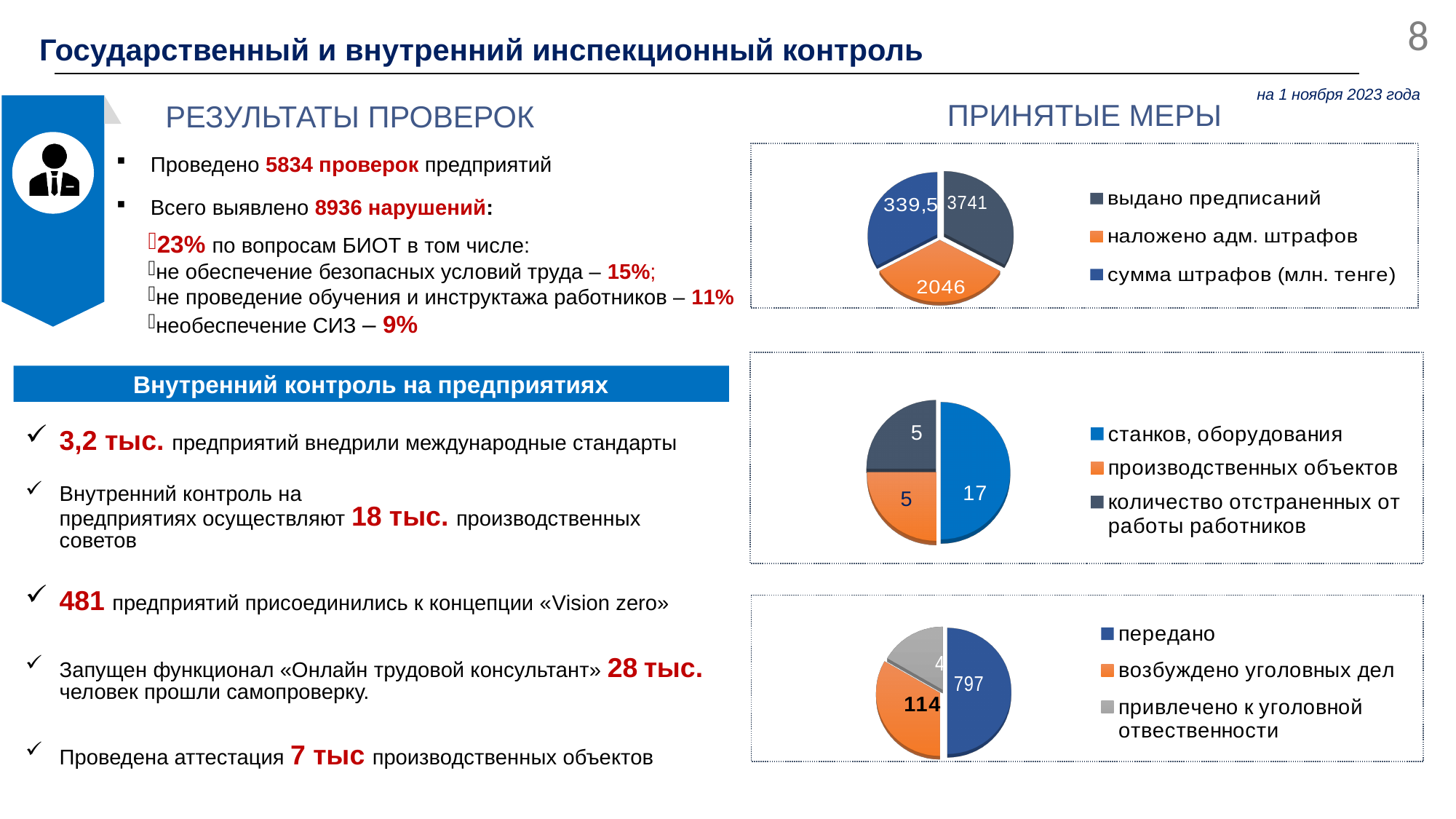
In the bottom pie chart on the right, what is the value for 'возбуждено уголовных дел'? 114 How many categories does the legend of the middle pie chart on the right list? 3 In the bottom pie chart on the right, what is the value for 'передано'? 797 In the top pie chart on the right, what is the value for 'сумма штрафов (млн. тенге)'? 339,5 What type of chart is the bottom chart on the right? pie chart In the middle pie chart on the right, what is the value for 'станков, оборудования'? 17 In the top pie chart on the right, what is the difference between 'выдано предписаний' and 'наложено адм. штрафов'? 1695 In the middle pie chart on the right, what is the value for 'производственных объектов'? 5 In the top pie chart on the right, what is the value for 'наложено адм. штрафов'? 2046 In the top pie chart on the right, what is the value for 'выдано предписаний'? 3741 In the middle pie chart on the right, which category has the largest slice? станков, оборудования